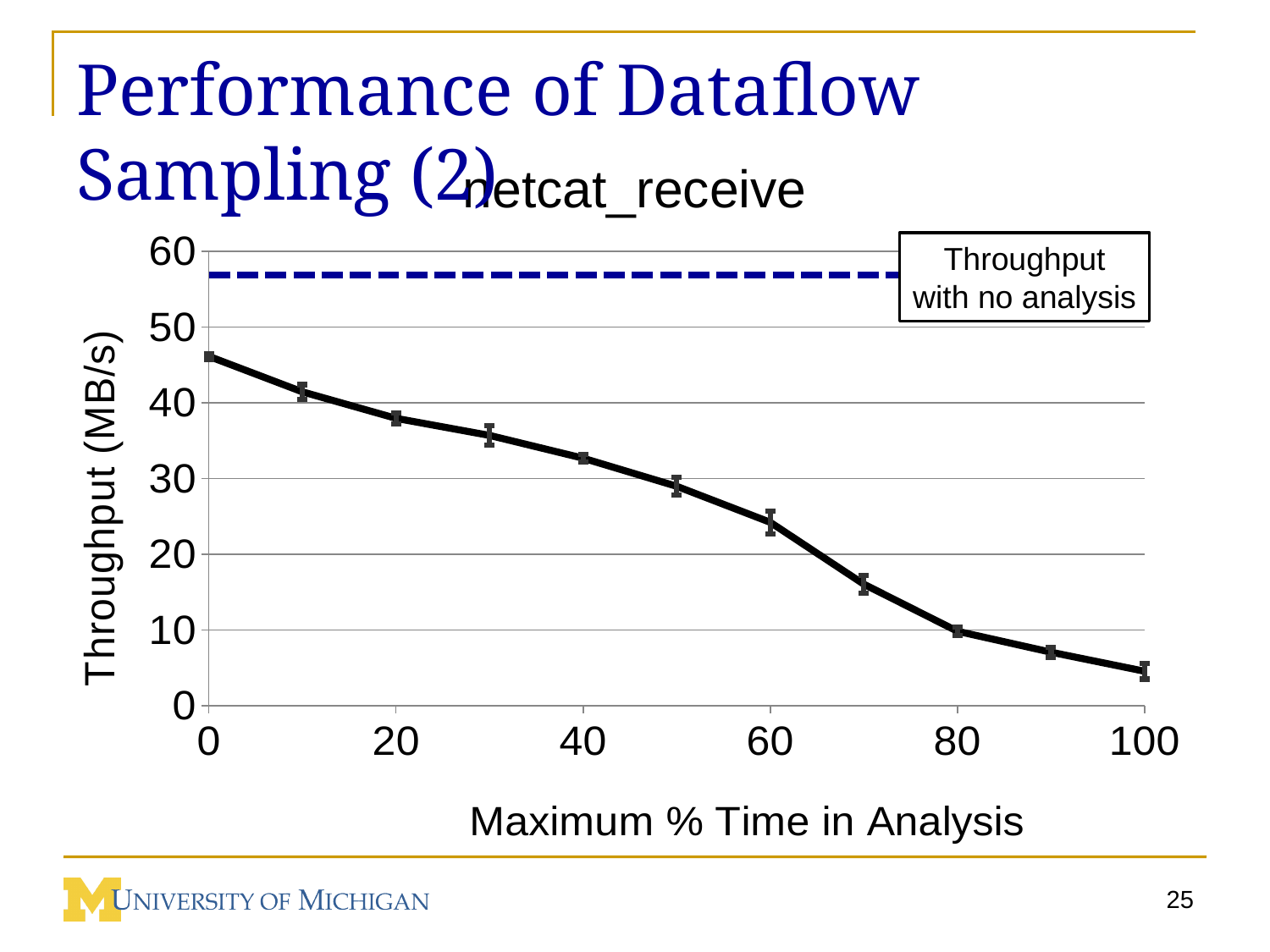
What is the title of the chart? netcat_receive How many data points are plotted on the solid line? 11 Is the throughput at 100% Maximum Time in Analysis greater or less than 10 MB/s? less What is the label of the y axis? Throughput (MB/s) Is the throughput at 60% Maximum Time in Analysis greater or less than 30 MB/s? less Which has higher throughput: 20% or 70% Maximum Time in Analysis? 20% Does throughput rise or fall as Maximum % Time in Analysis increases? fall Is the dashed 'Throughput with no analysis' line greater or less than 50 MB/s? greater What kind of chart is shown on the slide? line chart At which Maximum % Time in Analysis value is throughput highest? 0 At which Maximum % Time in Analysis value is throughput lowest? 100